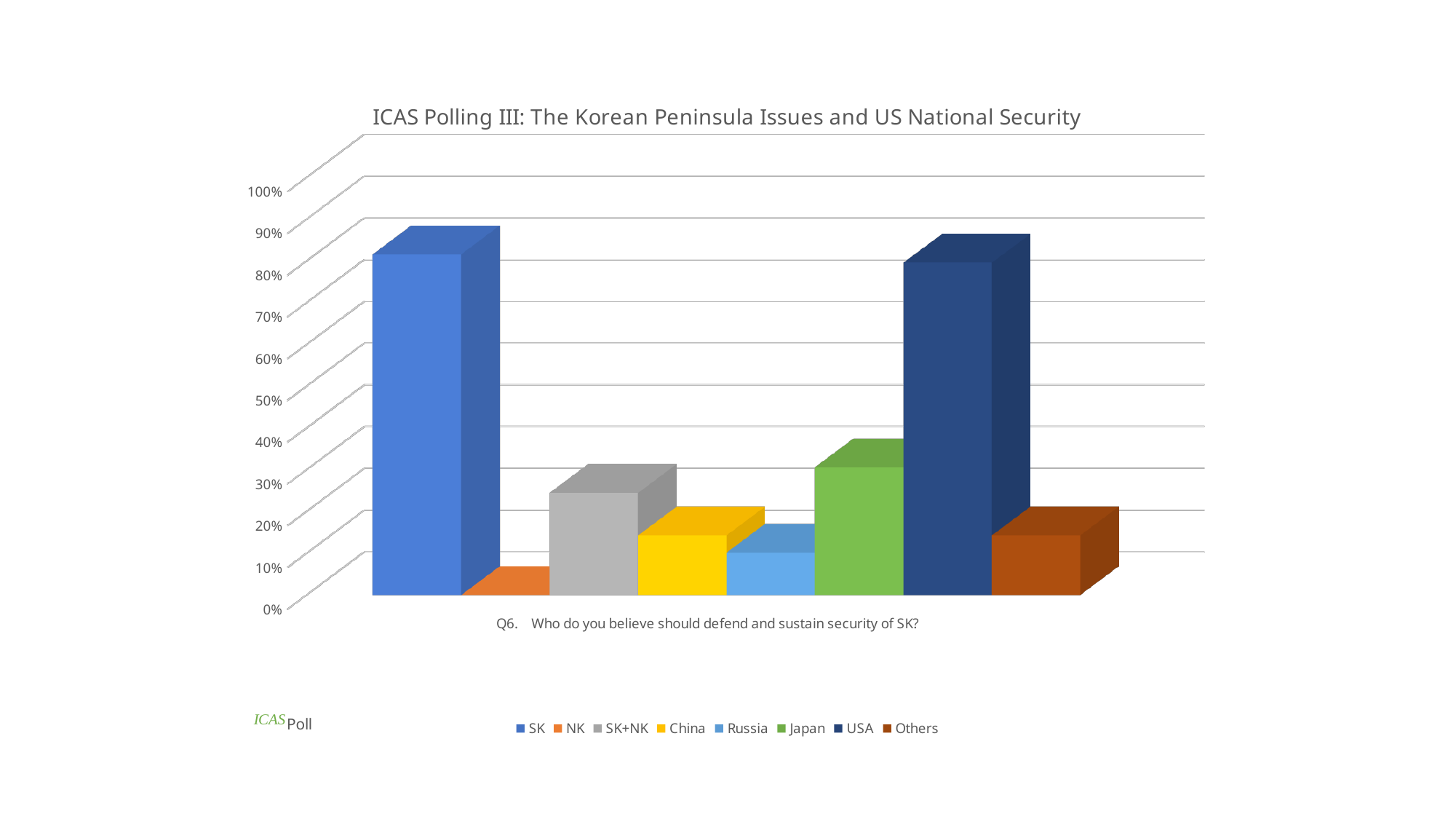
Which series has the lowest value for Q6? NK Which is larger, the value for Japan or the value for SK+NK? Japan Is the value for NK greater or less than 10%? less How many categories are shown on the x axis? 1 What kind of chart is shown on the slide? bar chart Is the value for Japan greater or less than 50%? less How many series does the legend list? 8 Is the value for USA greater or less than 70%? greater What is the title of the chart? ICAS Polling III: The Korean Peninsula Issues and US National Security Which is larger, the value for SK+NK or the value for China? SK+NK